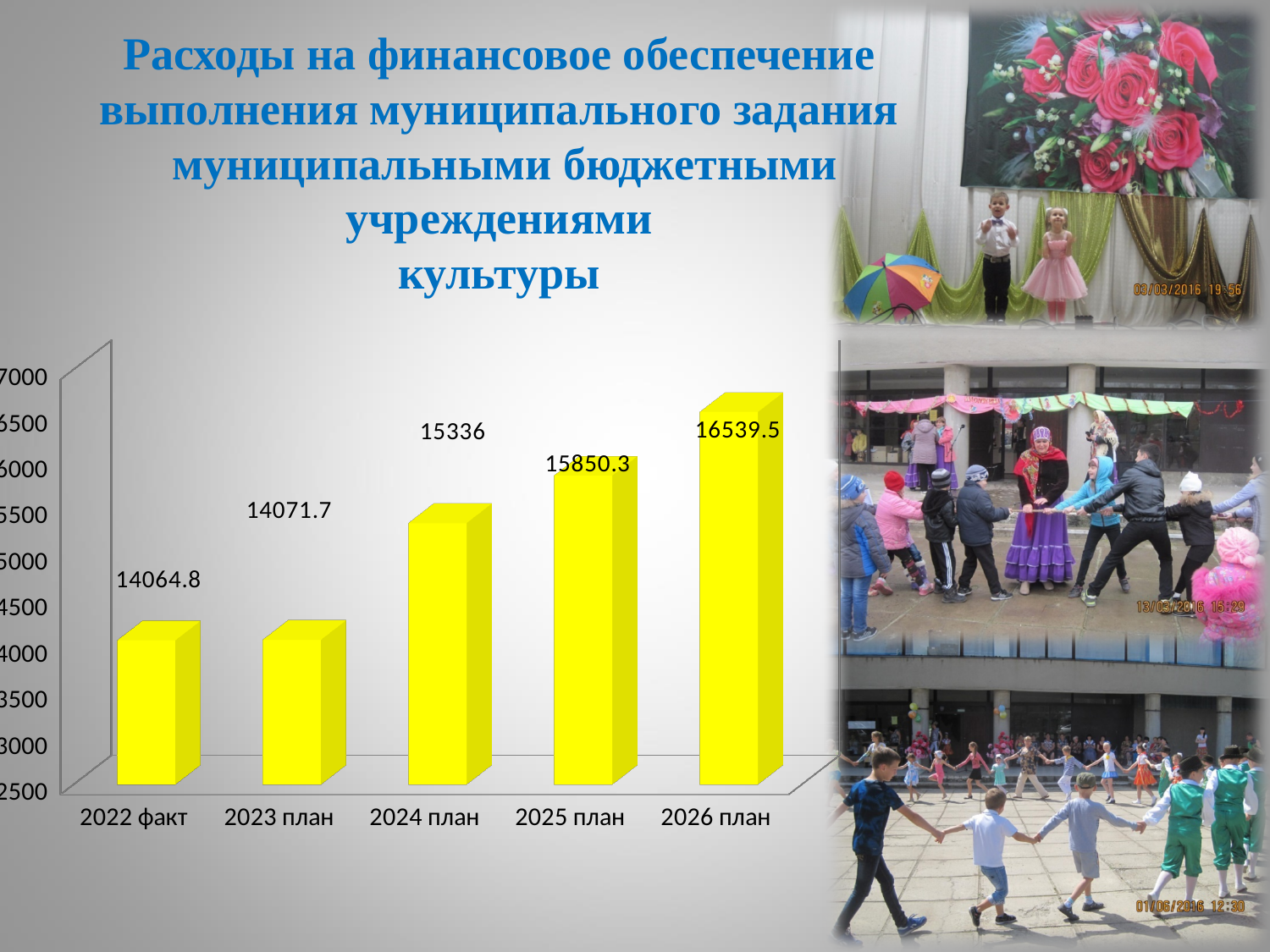
What is the difference between the values for 2026 план and 2025 план? 689.2 What is the value for 2025 план? 15850.3 Which is larger, the value for 2024 план or the value for 2025 план? 2025 план What is the value for 2022 факт? 14064.8 What is the value for 2024 план? 15336 Do the values rise or fall from 2022 факт to 2026 план? rise What kind of chart is shown on the slide? bar chart How many categories are shown on the x axis? 5 What is the value for 2026 план? 16539.5 Which category has the lowest value? 2022 факт Which category has the highest value? 2026 план What is the difference between the values for 2024 план and 2023 план? 1264.3